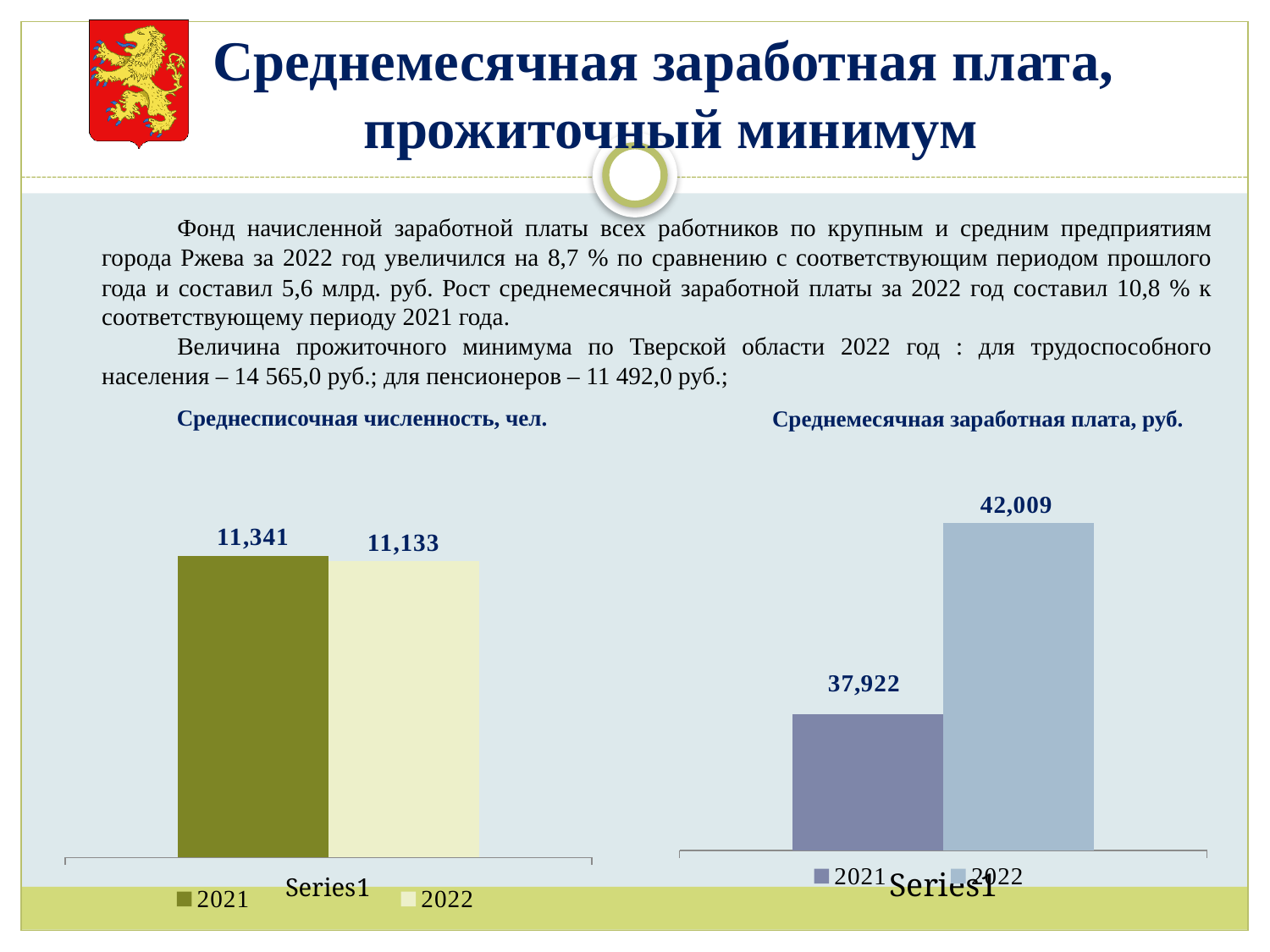
What are the legend entries of the chart titled 'Среднемесячная заработная плата, руб.'? 2021 and 2022 What type of chart is the chart titled 'Среднемесячная заработная плата, руб.'? Bar chart In the chart titled 'Среднемесячная заработная плата, руб.', which year has the lower value? 2021 In the chart titled 'Среднемесячная заработная плата, руб.', is the value for 2022 larger than the value for 2021? Yes How many series does the legend of the chart titled 'Среднесписочная численность, чел.' list? 2 In the chart titled 'Среднемесячная заработная плата, руб.', what is the value for 2021? 37,922 In the chart titled 'Среднесписочная численность, чел.', what is the difference between the 2021 and 2022 values? 208 In the chart titled 'Среднесписочная численность, чел.', what is the value for 2021? 11,341 In the chart titled 'Среднемесячная заработная плата, руб.', what is the value for 2022? 42,009 In the chart titled 'Среднемесячная заработная плата, руб.', by how much did the value increase from 2021 to 2022? 4,087 In the chart titled 'Среднесписочная численность, чел.', what is the value for 2022? 11,133 In the chart titled 'Среднесписочная численность, чел.', which year has the higher value? 2021